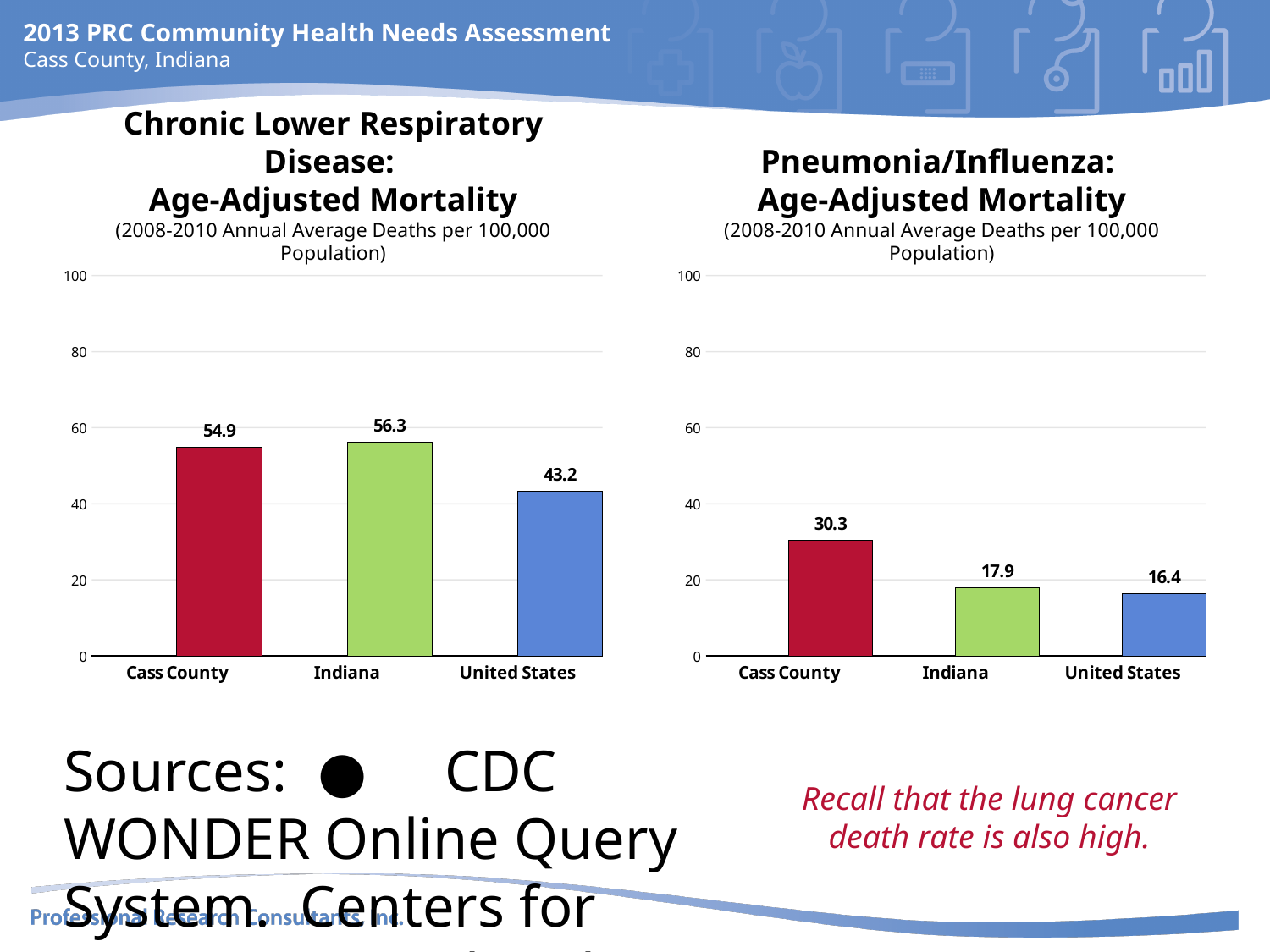
In the Chronic Lower Respiratory Disease chart, which category has the highest value? Indiana In the Pneumonia/Influenza chart, what is the difference between the Cass County value and the Indiana value? 12.4 In the Chronic Lower Respiratory Disease chart, what is the value for Cass County? 54.9 In the Pneumonia/Influenza chart, which is larger, the value for Cass County or the value for the United States? Cass County In the Chronic Lower Respiratory Disease chart, what is the difference between the Indiana value and the United States value? 13.1 In the Chronic Lower Respiratory Disease chart, is the value for Cass County greater or less than 40? greater In the Pneumonia/Influenza chart, what is the value for the United States? 16.4 How many categories are shown in the Pneumonia/Influenza chart? 3 In the Chronic Lower Respiratory Disease chart, which category has the lowest value? United States In the Pneumonia/Influenza chart, which category has the highest value? Cass County In the Pneumonia/Influenza chart, what is the value for Indiana? 17.9 What kind of chart is the Chronic Lower Respiratory Disease chart? Bar chart